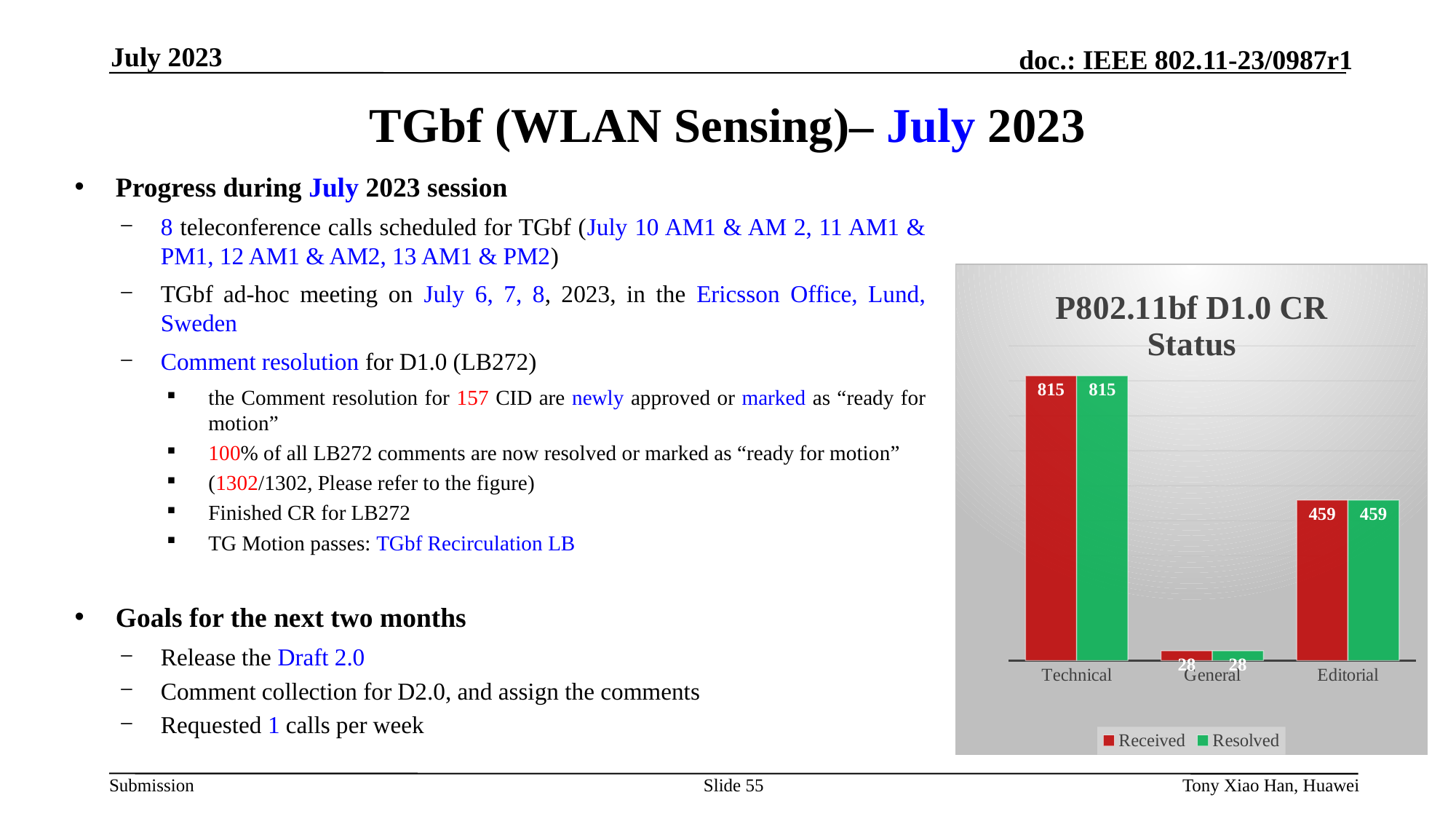
Which is larger, the Resolved value for Editorial or the Resolved value for General? Editorial What is the Resolved value for Editorial? 459 What is the Received value for Technical? 815 What is the difference between the Received values for Technical and Editorial? 356 How many series does the legend list? 2 Which category has the highest Received value? Technical Which colour represents the Resolved series? green What kind of chart is shown? bar chart How many categories are shown on the x axis? 3 Which category has the lowest Resolved value? General What is the Received value for General? 28 What is the title of the chart? P802.11bf D1.0 CR Status